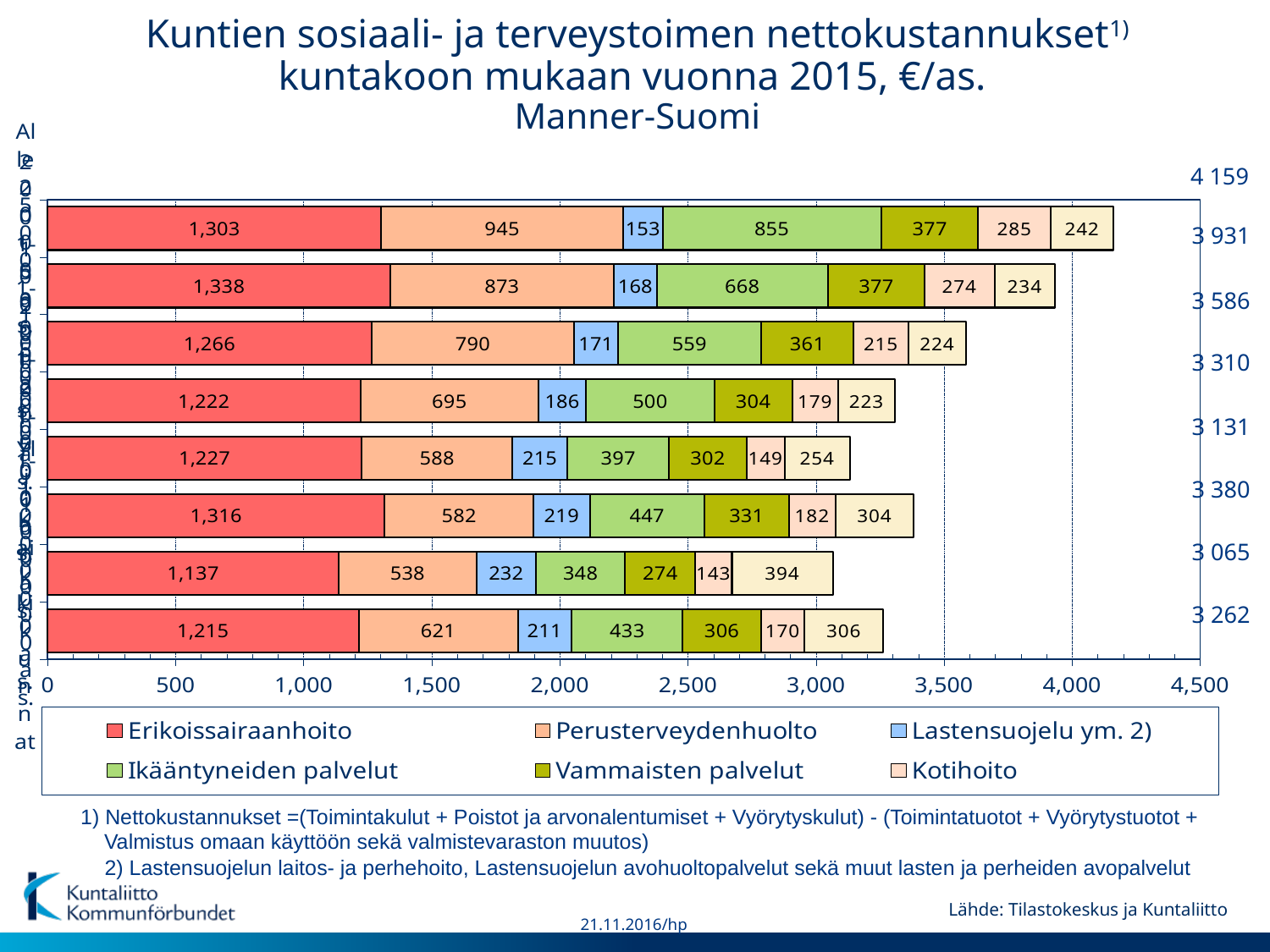
What is the Perusterveydenhuolto value in the bottom bar? 621 Which is larger: the Ikääntyneiden palvelut value in the top bar or in the second bar? The top bar (855) Which bar has the highest Erikoissairaanhoito value, and what is it? The second bar from the top, 1,338 What is the difference between the Perusterveydenhuolto values of the top bar and the second bar? 72 What is the lowest Erikoissairaanhoito value among the bars? 1,137 What kind of chart is shown on the slide? Stacked bar chart What is the Lastensuojelu ym. value in the second bar from the top? 168 What is the Erikoissairaanhoito value in the top bar? 1,303 What total is printed to the right of the top bar? 4 159 How many bars does the chart contain? 8 What is the Kotihoito value in the seventh bar from the top? 143 How many series does the legend list? 6